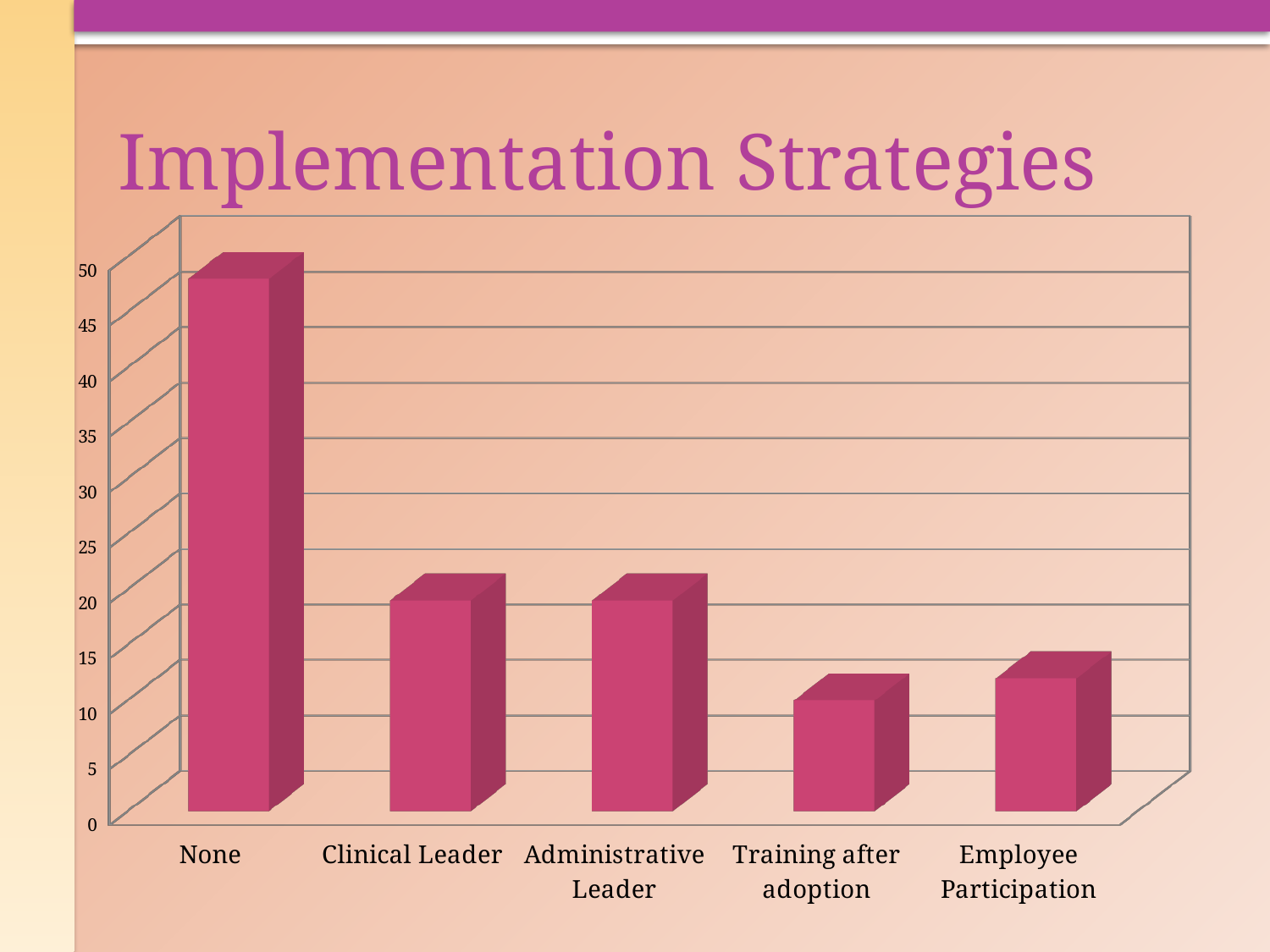
Is the value for Employee Participation greater or less than 15? less How many categories are shown on the x axis of the chart? 5 Which category has the highest value? None What is the title of the chart? Implementation Strategies What type of chart is shown on the slide? bar chart Is the value for None greater or less than 45? greater Is the value for Clinical Leader greater or less than 15? greater Which category has the lowest value? Training after adoption Which is larger, the value for None or the value for Clinical Leader? None Which is larger, the value for Employee Participation or the value for Training after adoption? Employee Participation